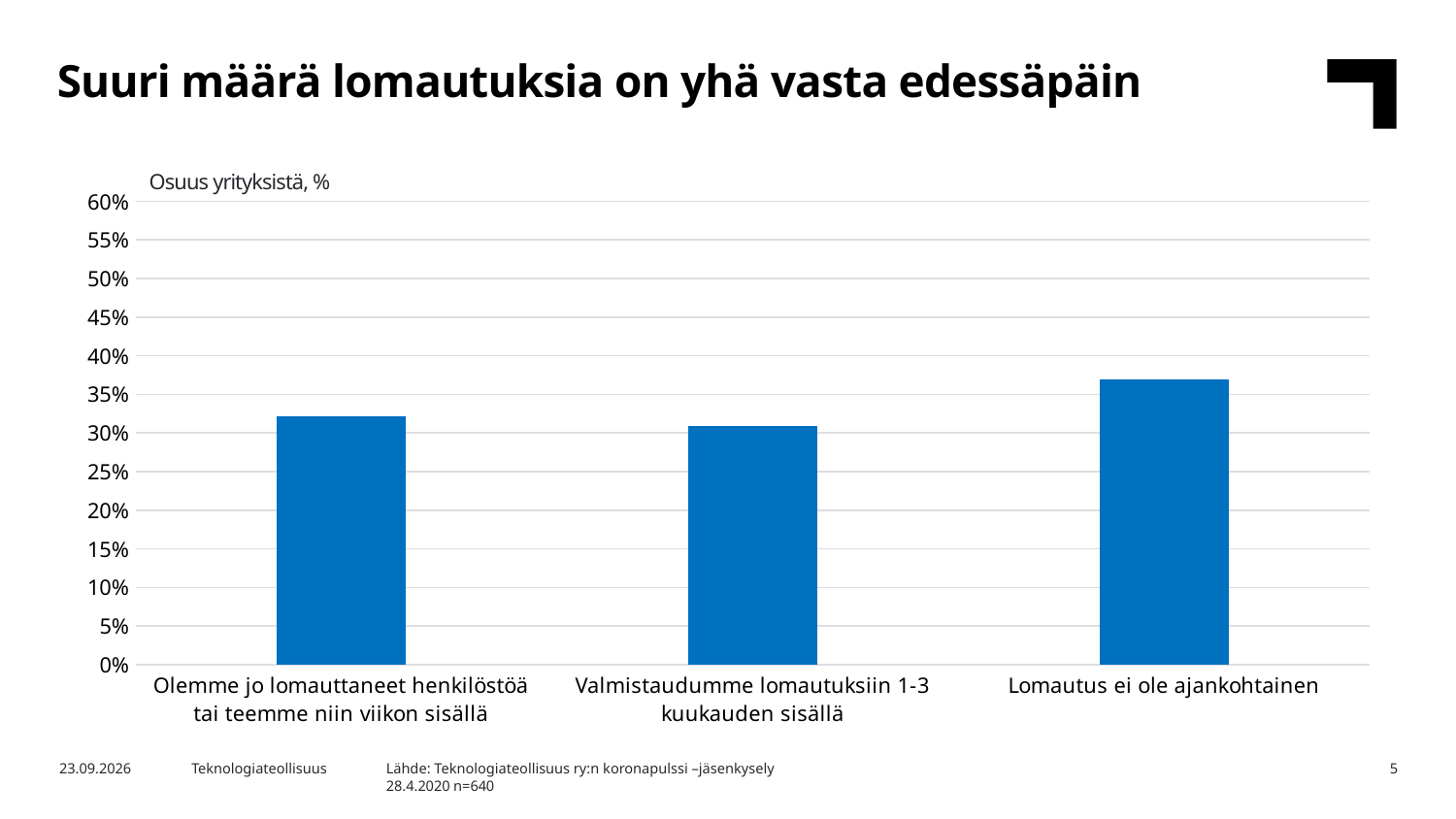
Is the value for "Lomautus ei ole ajankohtainen" greater or less than 35%? greater How many categories are shown in the chart? 3 Is the value for "Olemme jo lomauttaneet henkilöstöä tai teemme niin viikon sisällä" greater or less than 25%? greater What is the title of the slide containing the chart? Suuri määrä lomautuksia on yhä vasta edessäpäin What is the label shown above the vertical axis of the chart? Osuus yrityksistä, % Which category has the highest value in the chart? Lomautus ei ole ajankohtainen What kind of chart is shown on the slide? bar chart Is the value for "Valmistaudumme lomautuksiin 1-3 kuukauden sisällä" greater or less than 35%? less Which is larger: the value for "Lomautus ei ole ajankohtainen" or the value for "Valmistaudumme lomautuksiin 1-3 kuukauden sisällä"? Lomautus ei ole ajankohtainen